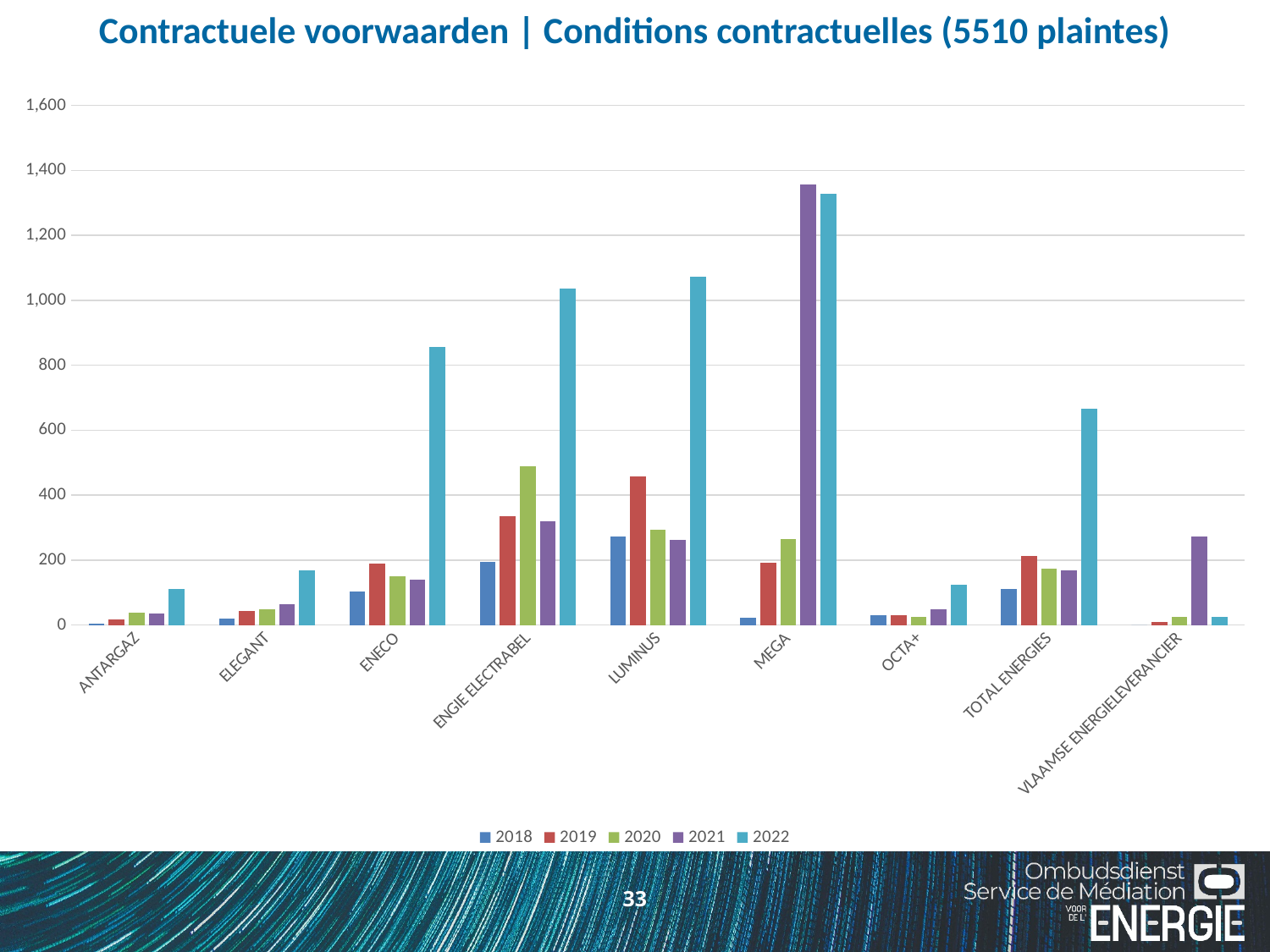
Is the 2022 value for ENECO greater or less than 800? greater Which supplier has the highest bar for 2022? MEGA Is the 2022 value for TOTAL ENERGIES greater or less than 600? greater Is the 2022 value for LUMINUS greater or less than 1,000? greater How many supplier categories are shown on the x axis? 9 How many series does the legend list? 5 Which supplier has the lowest bar for 2022? VLAAMSE ENERGIELEVERANCIER For ENGIE ELECTRABEL, which year has the highest bar? 2022 Which is larger: the 2019 value for LUMINUS or the 2019 value for ENGIE ELECTRABEL? LUMINUS For VLAAMSE ENERGIELEVERANCIER, which year has the highest bar? 2021 Do the values for ELEGANT rise or fall from 2018 to 2022? rise What kind of chart is shown on the slide? bar chart